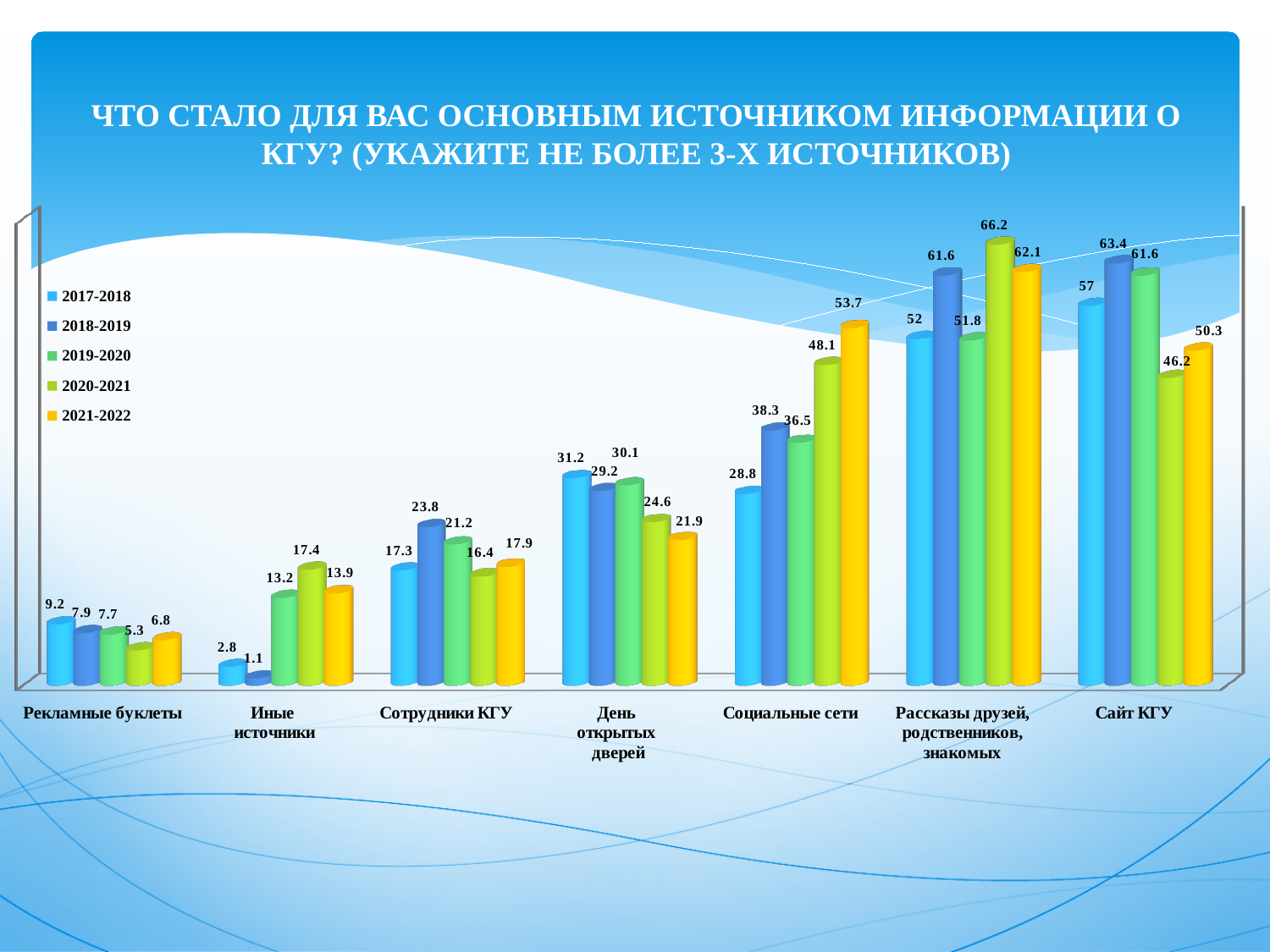
What is the value for Социальные сети in 2021-2022? 53.7 What is the value for День открытых дверей in 2020-2021? 24.6 How many categories are shown on the x axis? 7 What kind of chart is shown on the slide? Bar chart Which category has the lowest value in 2017-2018? Иные источники What is the difference between the 2021-2022 and 2017-2018 values for Социальные сети? 24.9 Which category has the highest value in 2020-2021? Рассказы друзей, родственников, знакомых What is the value for Сайт КГУ in 2018-2019? 63.4 Do the values for Социальные сети rise or fall from 2019-2020 to 2021-2022? Rise How many series does the legend list? 5 What is the value for Иные источники in 2018-2019? 1.1 Which is larger for Сайт КГУ: the 2019-2020 value or the 2020-2021 value? 2019-2020